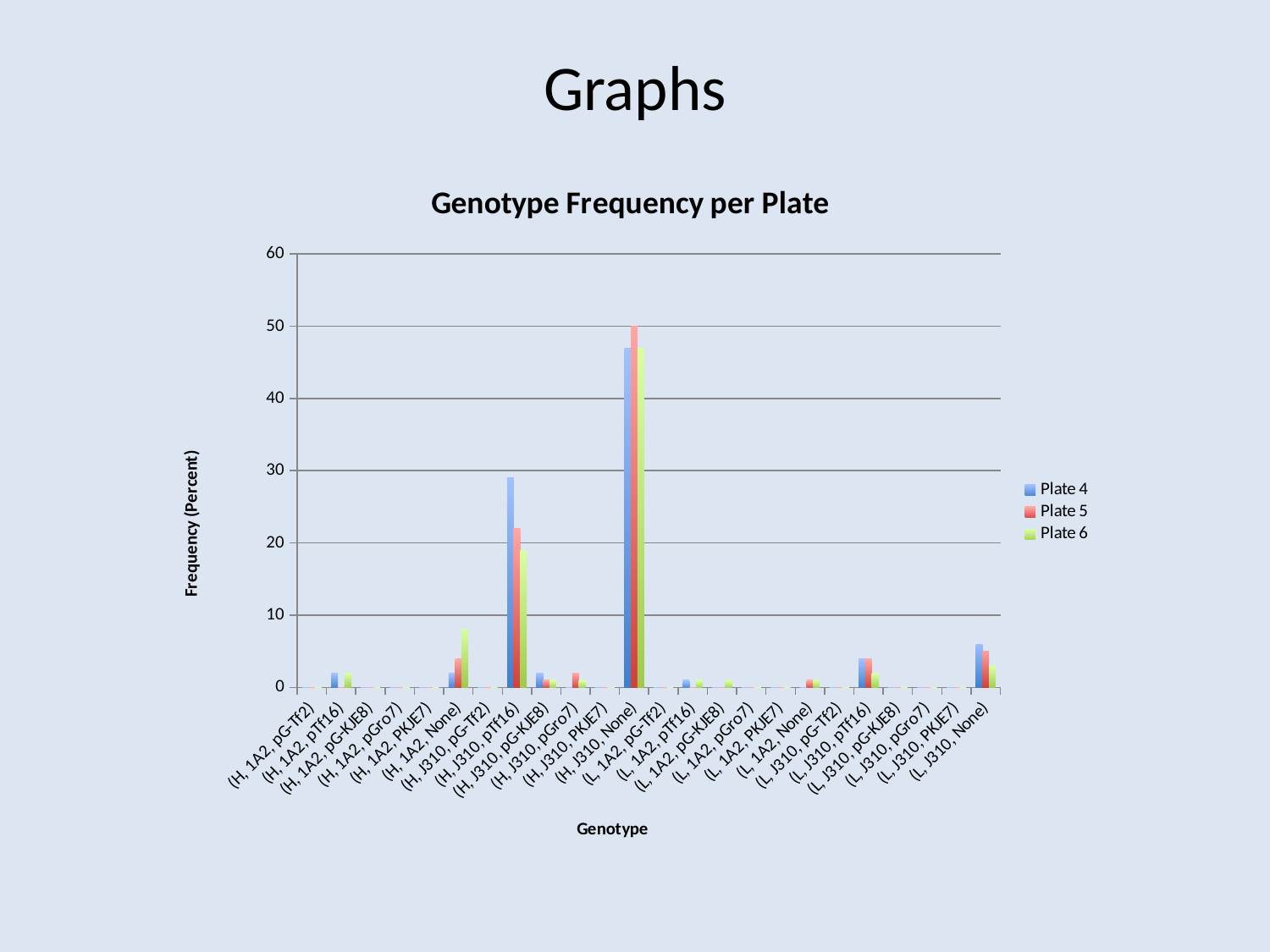
Which series has the tallest bar at (H, J310, None)? Plate 5 What type of chart is shown on the slide? Bar chart What is the title of the chart? Genotype Frequency per Plate Is the Plate 4 value for (H, J310, None) greater or less than 40? greater How many series does the legend list? 3 Is the Plate 4 value for (H, J310, pTf16) greater or less than 20? greater At (H, 1A2, None), which is larger: the Plate 4 value or the Plate 6 value? Plate 6 At (H, J310, pTf16), which is larger: the Plate 4 value or the Plate 6 value? Plate 4 Which genotype has the highest frequency for Plate 4? (H, J310, None) How many genotype categories are shown on the x axis? 24 What is the label of the vertical axis? Frequency (Percent)